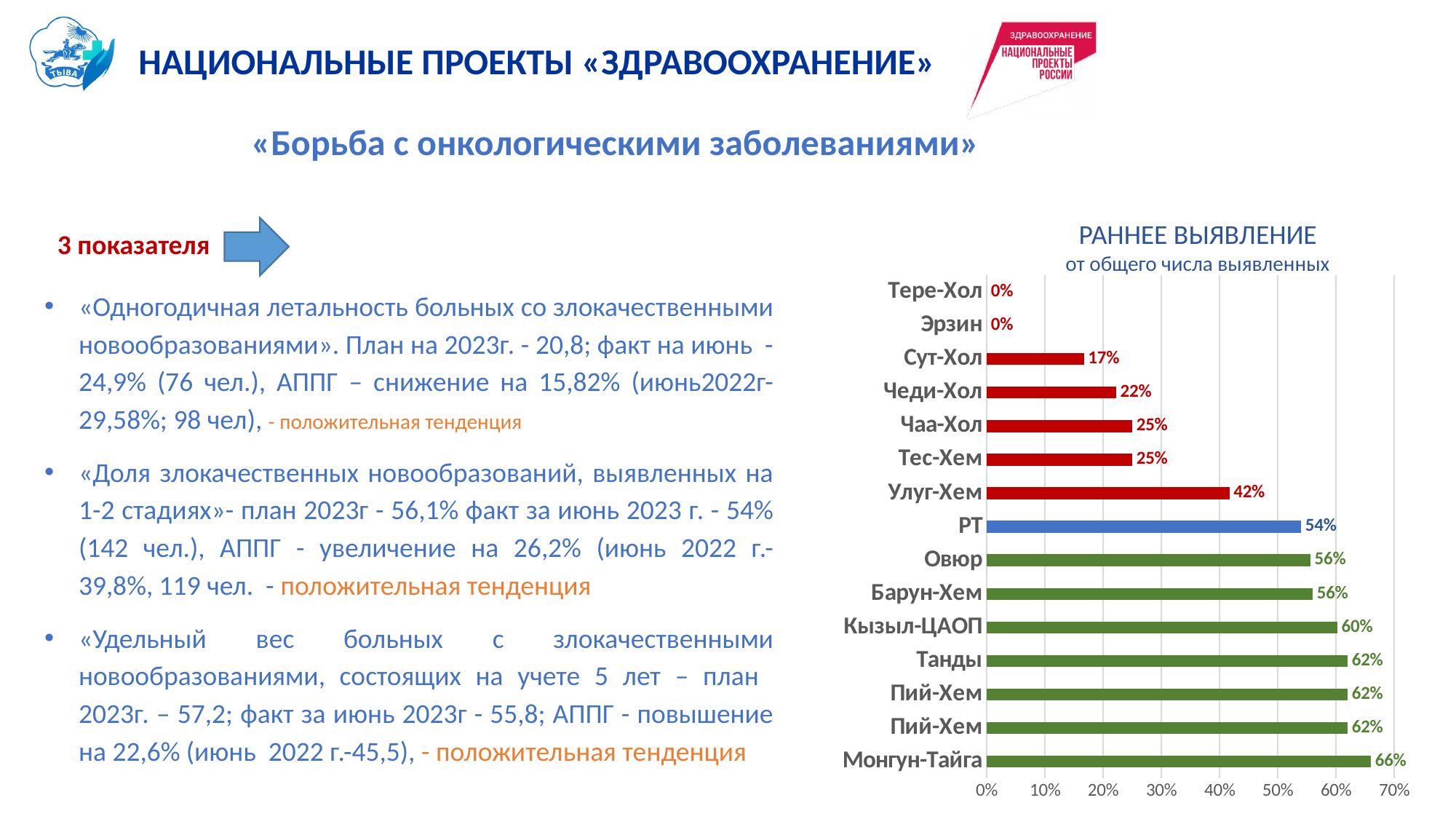
What kind of chart is shown on the slide? bar chart What is the difference between the values for Монгун-Тайга and РТ? 12% What is the value for Улуг-Хем in the chart? 42% What is the value for Кызыл-ЦАОП in the chart? 60% Which has a larger value, Овюр or Чаа-Хол? Овюр Which category has the highest value in the chart? Монгун-Тайга What is the title of the chart? РАННЕЕ ВЫЯВЛЕНИЕ от общего числа выявленных What is the value for Сут-Хол in the chart? 17% How many categories in the chart have a value of 0%? 2 What is the difference between the values for Улуг-Хем and Чеди-Хол? 20% What is the value for РТ in the chart? 54% How many categories are shown in the chart? 15